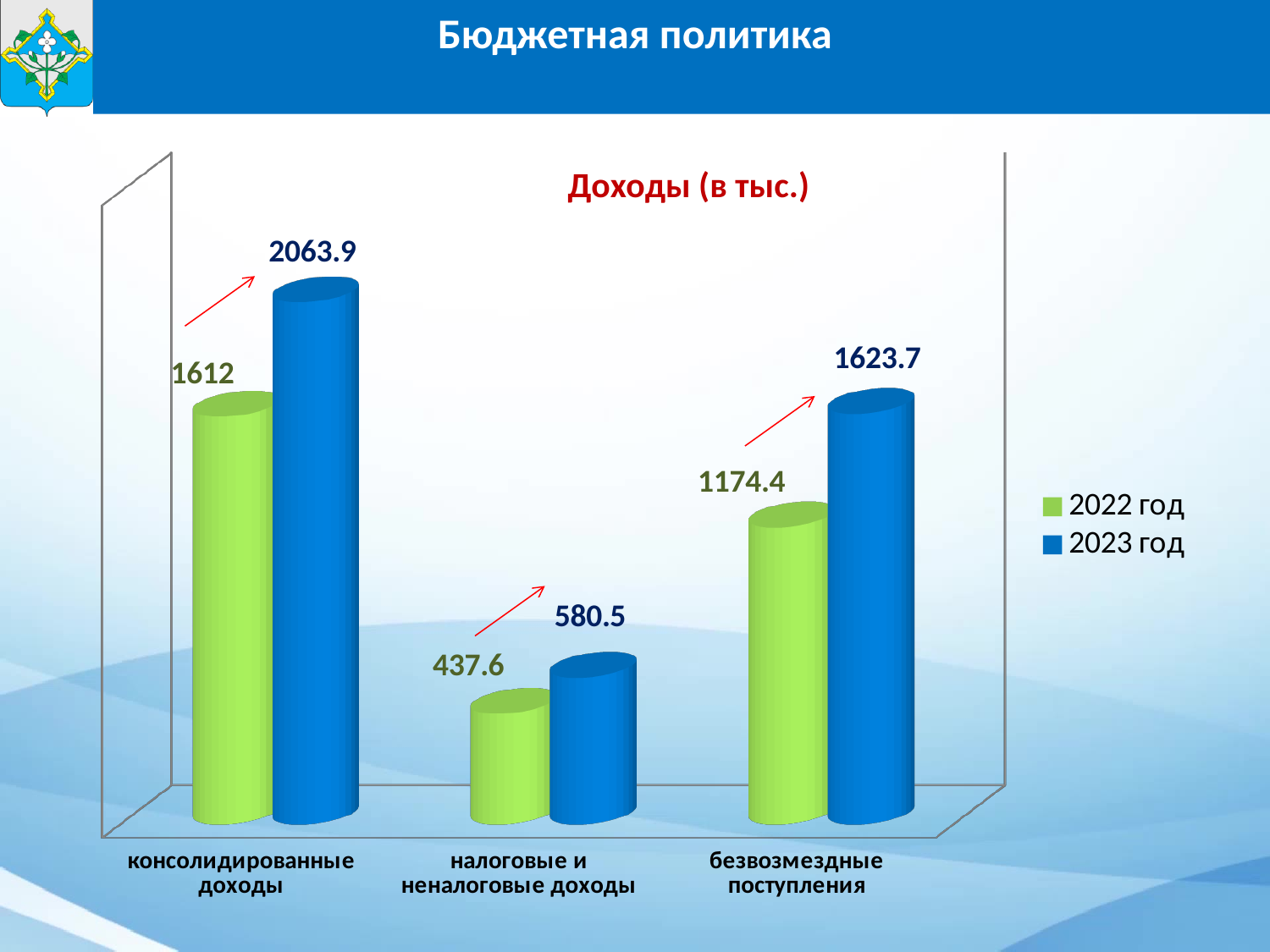
Which is larger for безвозмездные поступления: the 2022 год value or the 2023 год value? 2023 год What is the value for консолидированные доходы in 2023 год? 2063.9 What is the difference between the 2023 год and 2022 год values for налоговые и неналоговые доходы? 142.9 How many categories are shown on the x axis? 3 Which category has the highest value in 2023 год? консолидированные доходы What is the value for безвозмездные поступления in 2023 год? 1623.7 How many series does the legend list? 2 What is the difference between the 2023 год and 2022 год values for консолидированные доходы? 451.9 Which category has the lowest value in 2022 год? налоговые и неналоговые доходы What is the value for консолидированные доходы in 2022 год? 1612 What kind of chart is shown on the slide? bar chart What is the value for налоговые и неналоговые доходы in 2022 год? 437.6